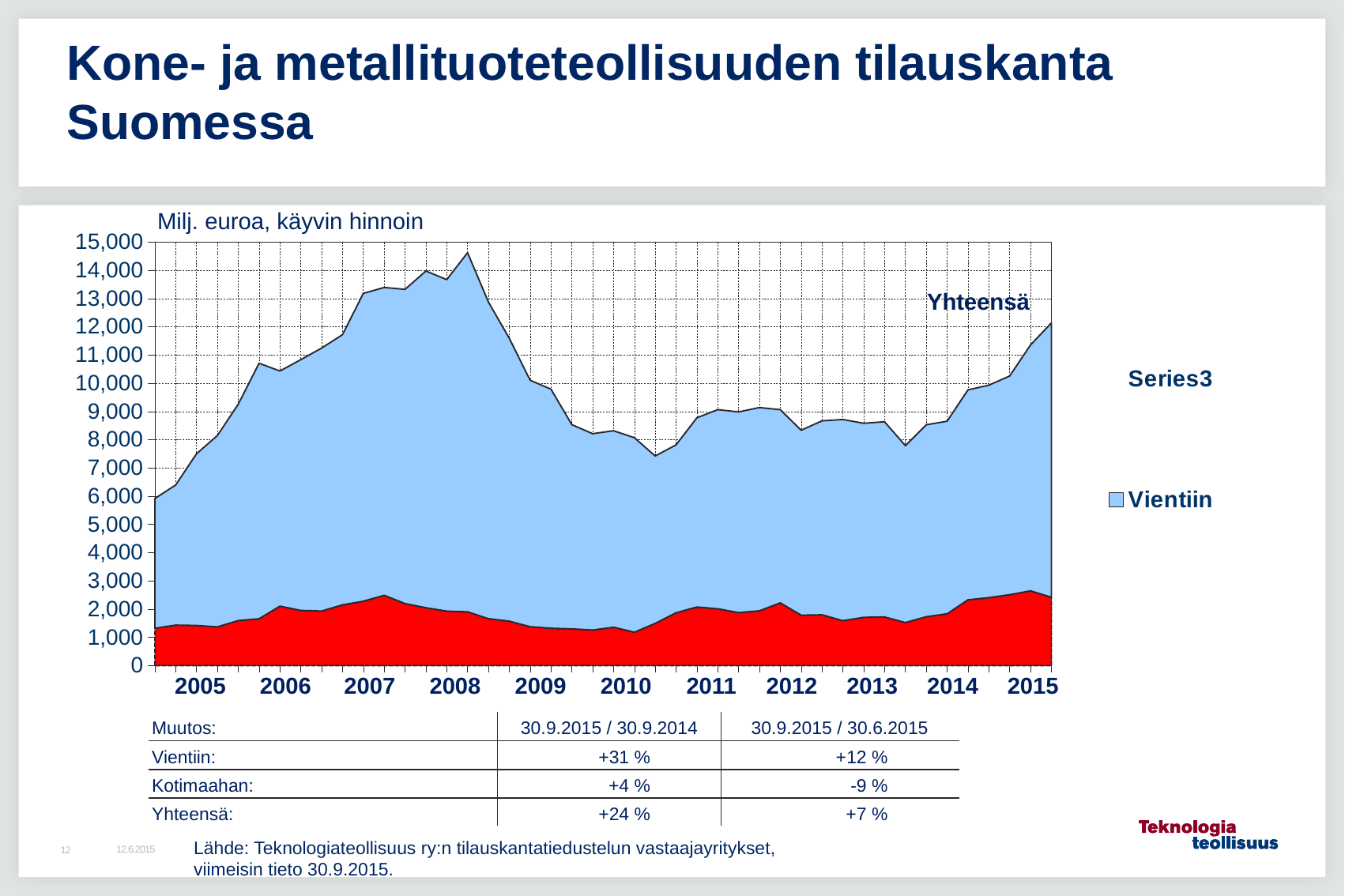
In which year does the total (Yhteensä) reach its highest peak? 2008 Is the peak total value in 2008 greater or less than 14,000? greater Is the total value at the start of 2005 greater or less than 5,000? greater How many series does the chart legend list? 2 Does the total order backlog rise or fall between the 2008 peak and 2010? fall Is the red (domestic) area ever greater than 3,000 at any point? No What are the two entries in the chart legend? Series3 and Vientiin Is the total value higher in 2008 or in 2010? 2008 How many year labels are shown on the x axis? 11 What kind of chart is shown on the slide? area chart What unit label is shown above the chart's y axis? Milj. euroa, käyvin hinnoin